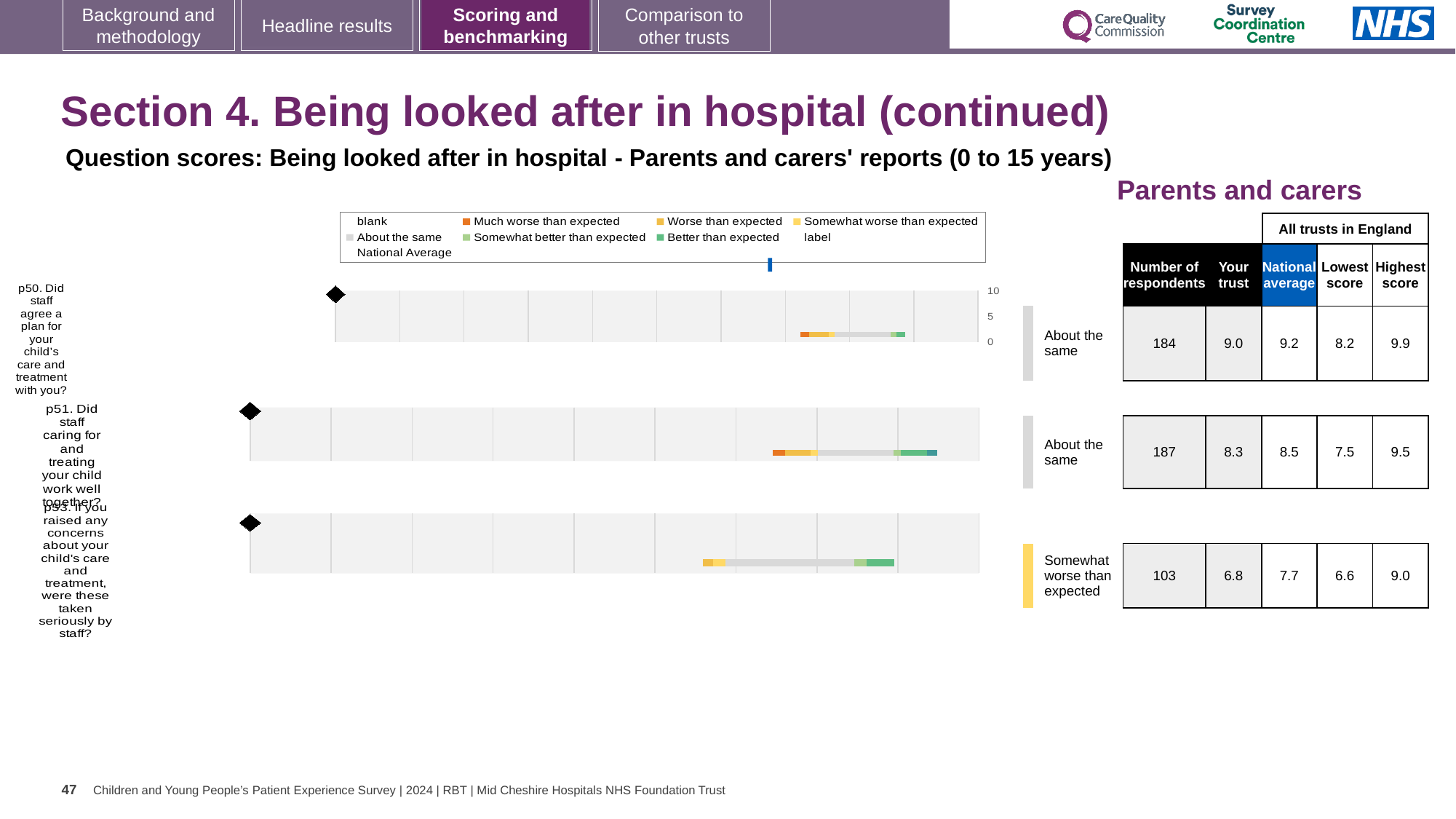
For question p53, what is the difference between the national average and the 'Your trust' score? 0.9 For question p51 (Did staff caring for and treating your child work well together?), what is the national average score? 8.5 For question p50 (Did staff agree a plan for your child's care and treatment with you?), what is the 'Your trust' score? 9.0 How many questions are shown on this slide? 3 For question p51, which is larger: the 'Your trust' score or the national average? National average For question p53, what is the highest score among all trusts in England? 9.0 Which question has the lowest 'Your trust' score? p53 For question p50, what is the lowest score among all trusts in England? 8.2 For question p53 (If you raised any concerns about your child's care and treatment, were these taken seriously by staff?), how many respondents are there? 103 For question p51, what is the difference between the highest score and the lowest score? 2.0 Which question has the highest 'Your trust' score? p50 What benchmark category is shown for question p53? Somewhat worse than expected